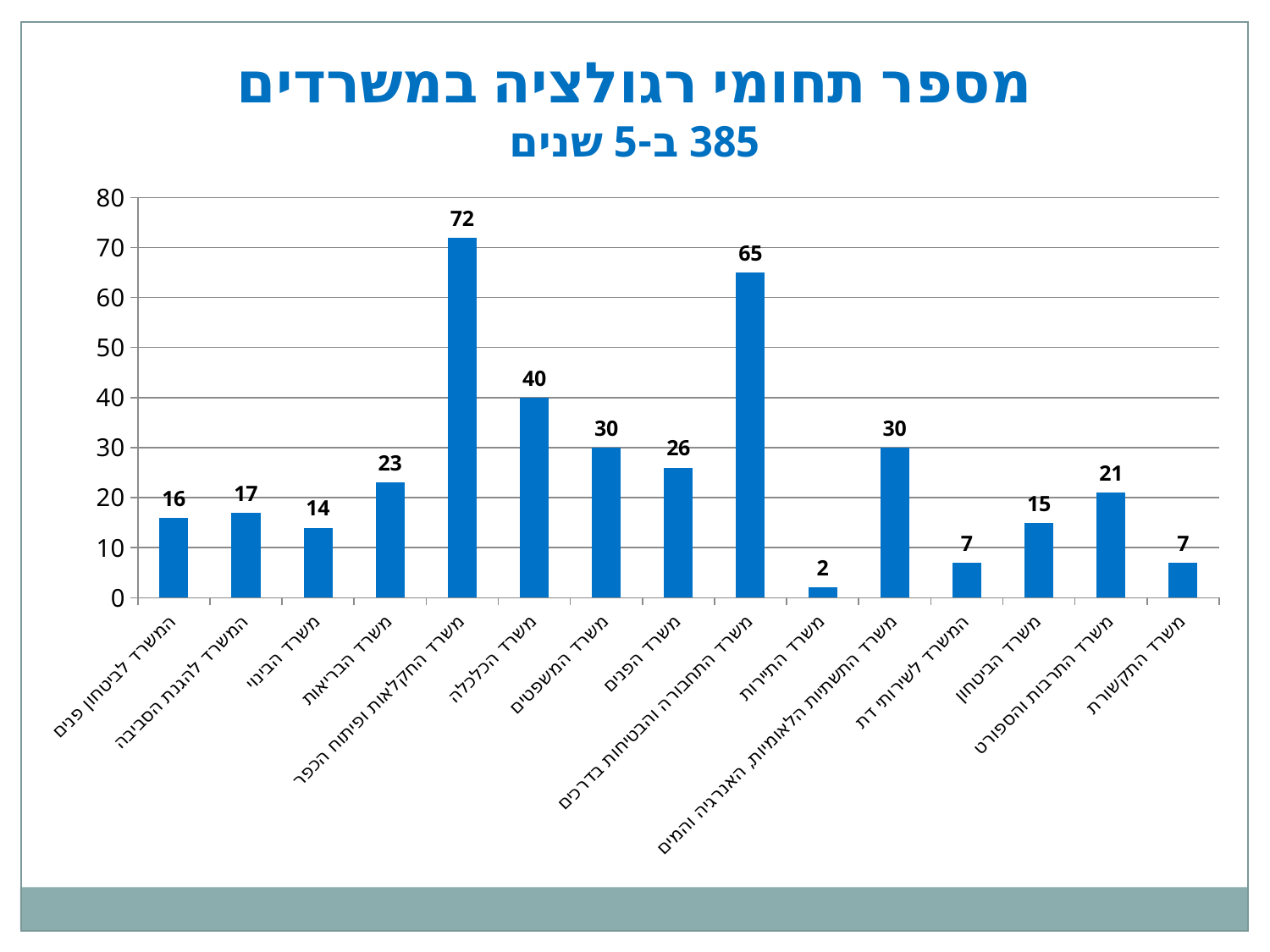
What is the difference between the values for משרד התרבות והספורט and משרד הביטחון? 6 Is the value for משרד התחבורה והבטיחות בדרכים greater or less than 60? greater Which ministry has the lowest value? משרד התיירות What is the title of the chart? מספר תחומי רגולציה במשרדים What kind of chart is shown on the slide? bar chart Which ministry has the highest value? משרד החקלאות ופיתוח הכפר What is the value for משרד החקלאות ופיתוח הכפר? 72 How many ministries are shown on the chart? 15 What is the value for משרד הכלכלה? 40 Which is larger, the value for משרד הפנים or the value for משרד הבריאות? משרד הפנים What is the value for משרד התיירות? 2 What is the difference between the values for משרד החקלאות ופיתוח הכפר and משרד התחבורה והבטיחות בדרכים? 7